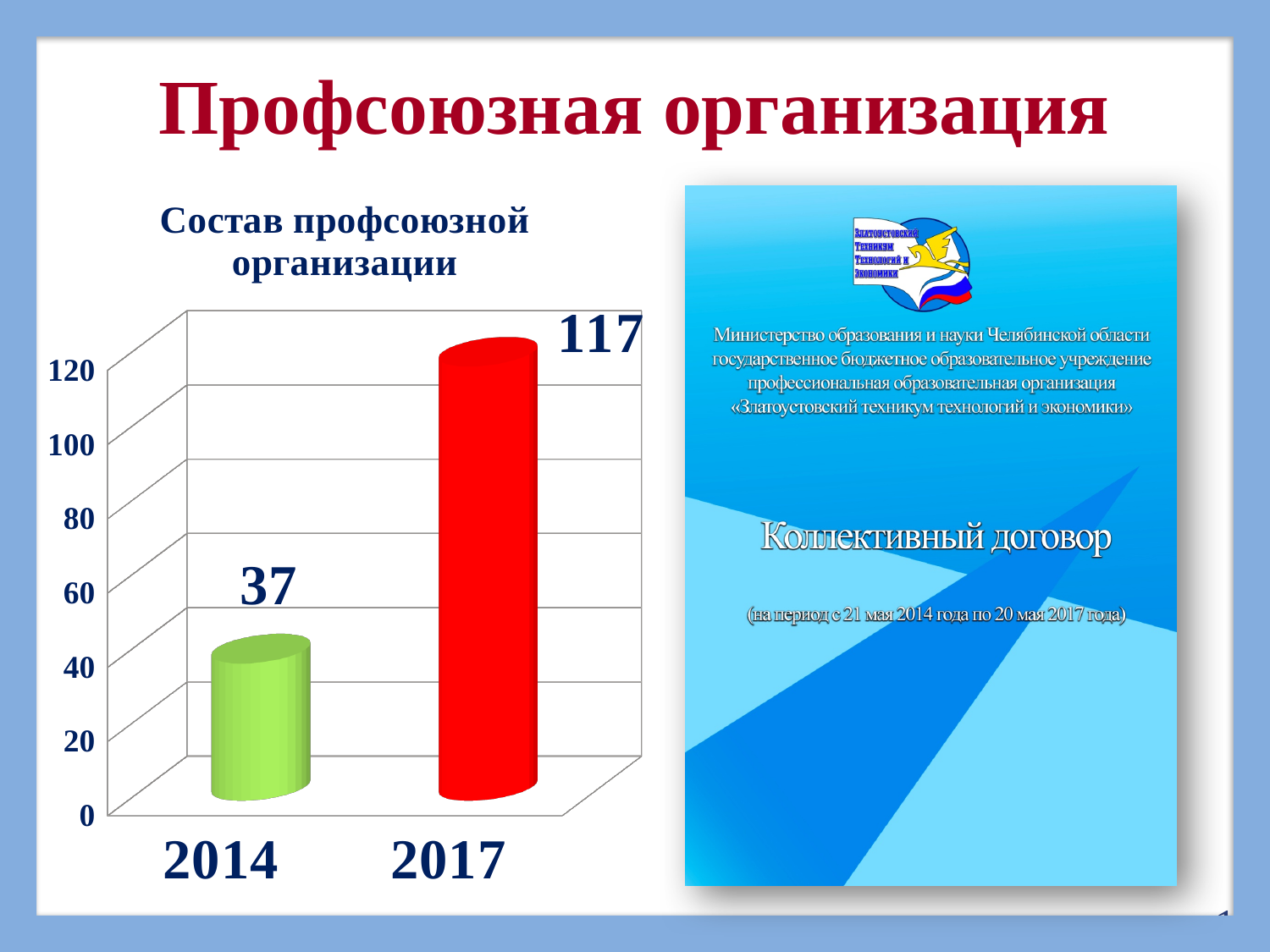
Is the value for 2017 greater or less than 100? greater What is the value for 2017 in the chart 'Состав профсоюзной организации'? 117 Is the value for 2014 greater or less than 40? less What is the value for 2014 in the chart 'Состав профсоюзной организации'? 37 What kind of chart is shown on the slide? bar chart What is the difference between the values for 2017 and 2014? 80 Which is larger, the value for 2014 or the value for 2017? 2017 What is the title of the chart on the slide? Состав профсоюзной организации How many categories are shown on the x axis of the chart? 2 Which year has the highest value in the chart? 2017 Which year has the lowest value in the chart? 2014 Do the values rise or fall from 2014 to 2017? rise